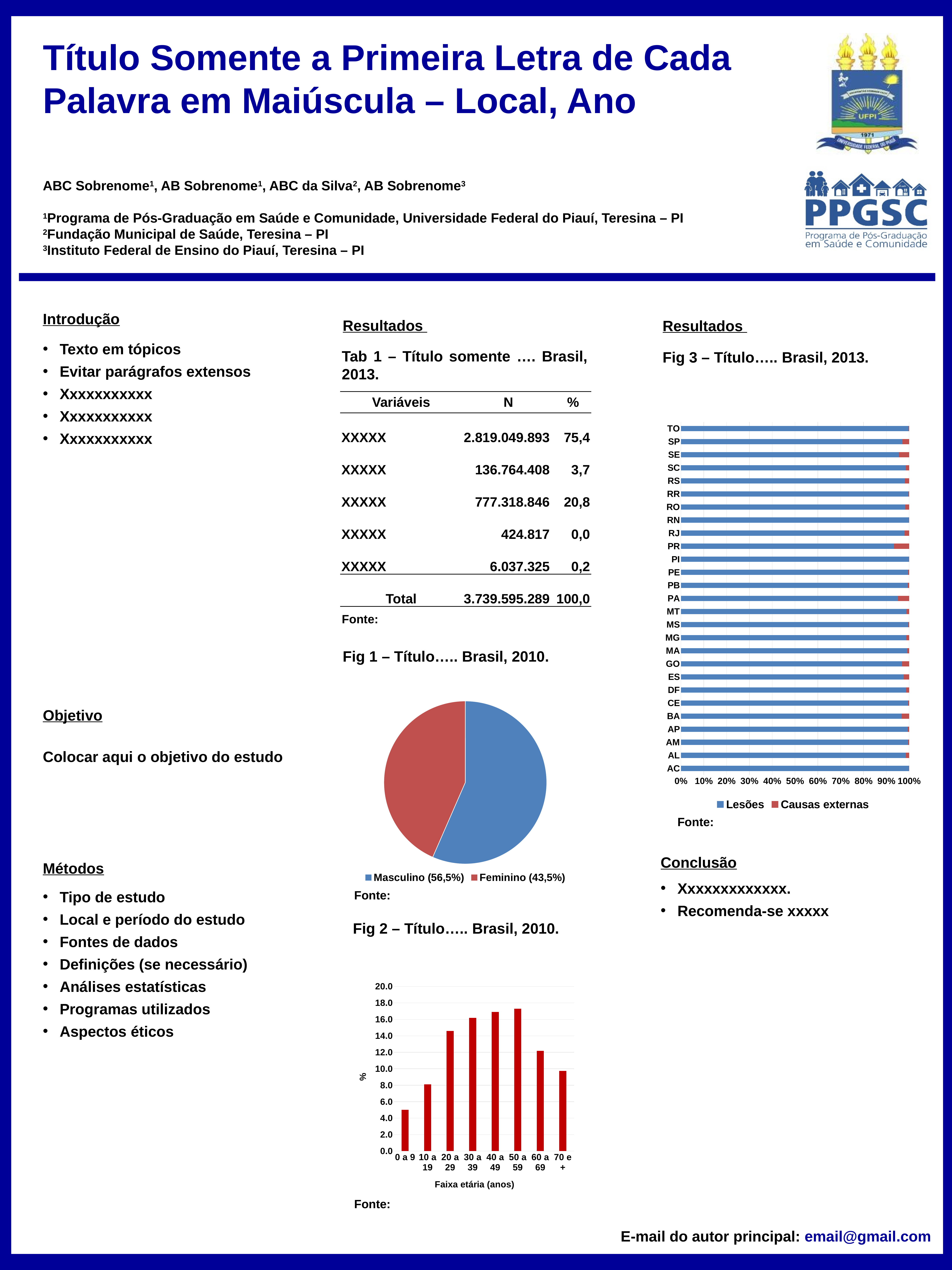
What kind of chart is Fig 1 – Título….. Brasil, 2010? pie chart In Fig 2 – Título….. Brasil, 2010, which age group has the lowest value? 0 a 9 How many states (categories) are plotted in Fig 3 – Título….. Brasil, 2013? 27 In Fig 2 – Título….. Brasil, 2010, is the value for 70 e + greater or less than 12.0? less In Fig 1 – Título….. Brasil, 2010, which slice is larger, Masculino or Feminino? Masculino How many series does the legend list in Fig 3 – Título….. Brasil, 2013? 2 In Fig 2 – Título….. Brasil, 2010, do the values rise or fall from 0 a 9 to 50 a 59? rise In Fig 1 – Título….. Brasil, 2010, what share of the pie is Masculino? 56,5% What kind of chart is Fig 2 – Título….. Brasil, 2010? bar chart How many age-group categories are shown in Fig 2 – Título….. Brasil, 2010? 8 In Fig 1 – Título….. Brasil, 2010, what share of the pie is Feminino? 43,5% In Fig 2 – Título….. Brasil, 2010, which age group has the highest value? 50 a 59